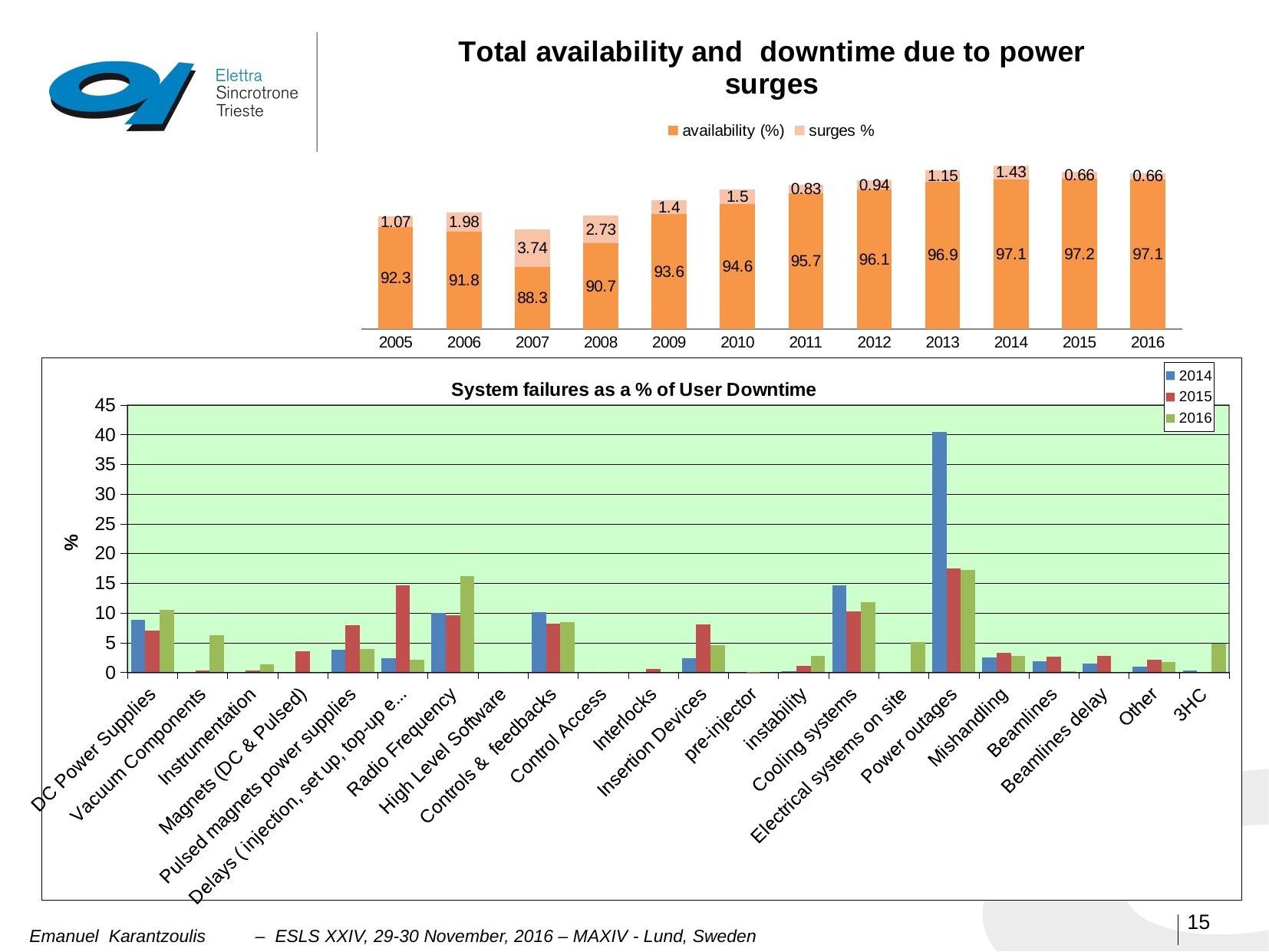
In the top chart 'Total availability and downtime due to power surges', what is the surges % value for 2008? 2.73 In the top chart 'Total availability and downtime due to power surges', which year has the lowest availability (%)? 2007 In the top chart 'Total availability and downtime due to power surges', how many years are shown on the x axis? 12 In the top chart 'Total availability and downtime due to power surges', what is the difference between the availability (%) for 2016 and for 2005? 4.8 In the bottom chart 'System failures as a % of User Downtime', which category has the highest bar overall? Power outages In the top chart 'Total availability and downtime due to power surges', what is the availability (%) value for 2007? 88.3 In the top chart 'Total availability and downtime due to power surges', which year has the highest surges % value? 2007 In the bottom chart 'System failures as a % of User Downtime', is the 2016 value for Cooling systems greater or less than 10? greater In the top chart 'Total availability and downtime due to power surges', what is the total of the stacked bar for 2007 (availability plus surges)? 92.04 In the bottom chart 'System failures as a % of User Downtime', how many series does the legend list? 3 In the top chart 'Total availability and downtime due to power surges', does availability (%) generally rise or fall from 2007 to 2016? rise In the bottom chart 'System failures as a % of User Downtime', is the 2014 value for Power outages greater or less than 35? greater